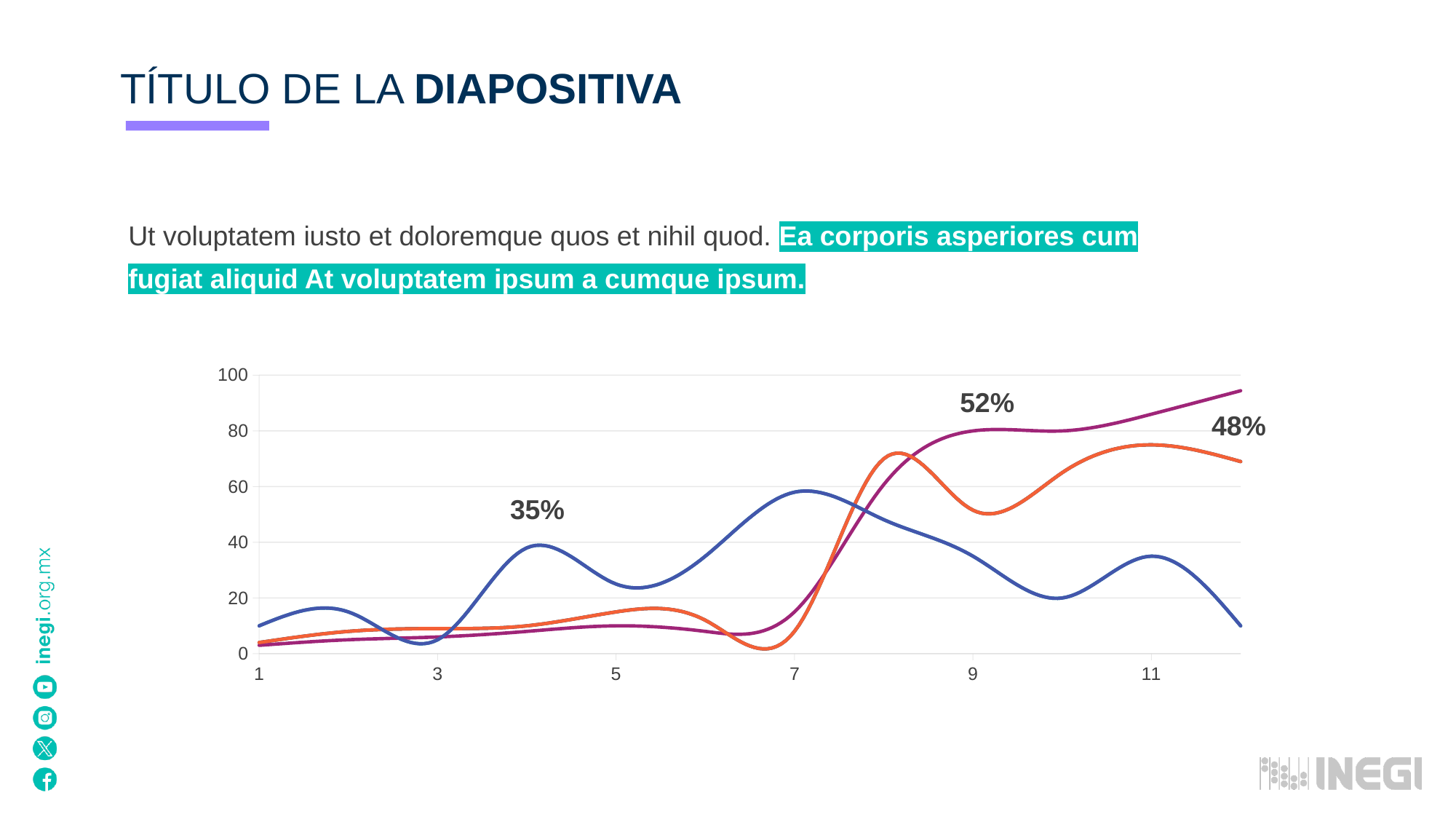
Is the value of the blue line at x = 12 greater or less than 20? less What kind of chart is shown on the slide? line chart Is the value of the orange line at x = 12 greater or less than 80? less Is the value of the purple line at x = 1 greater or less than 20? less How many lines are plotted on the chart? 3 At x = 12, which line has the higher value, the purple line or the orange line? purple line Which line reaches the highest value at the right end of the chart (x = 12)? purple line Does the purple line generally rise or fall from x = 1 to x = 12? rise At x = 9, which line has the higher value, the purple line or the blue line? purple line What is the highest value shown on the vertical axis of the chart? 100